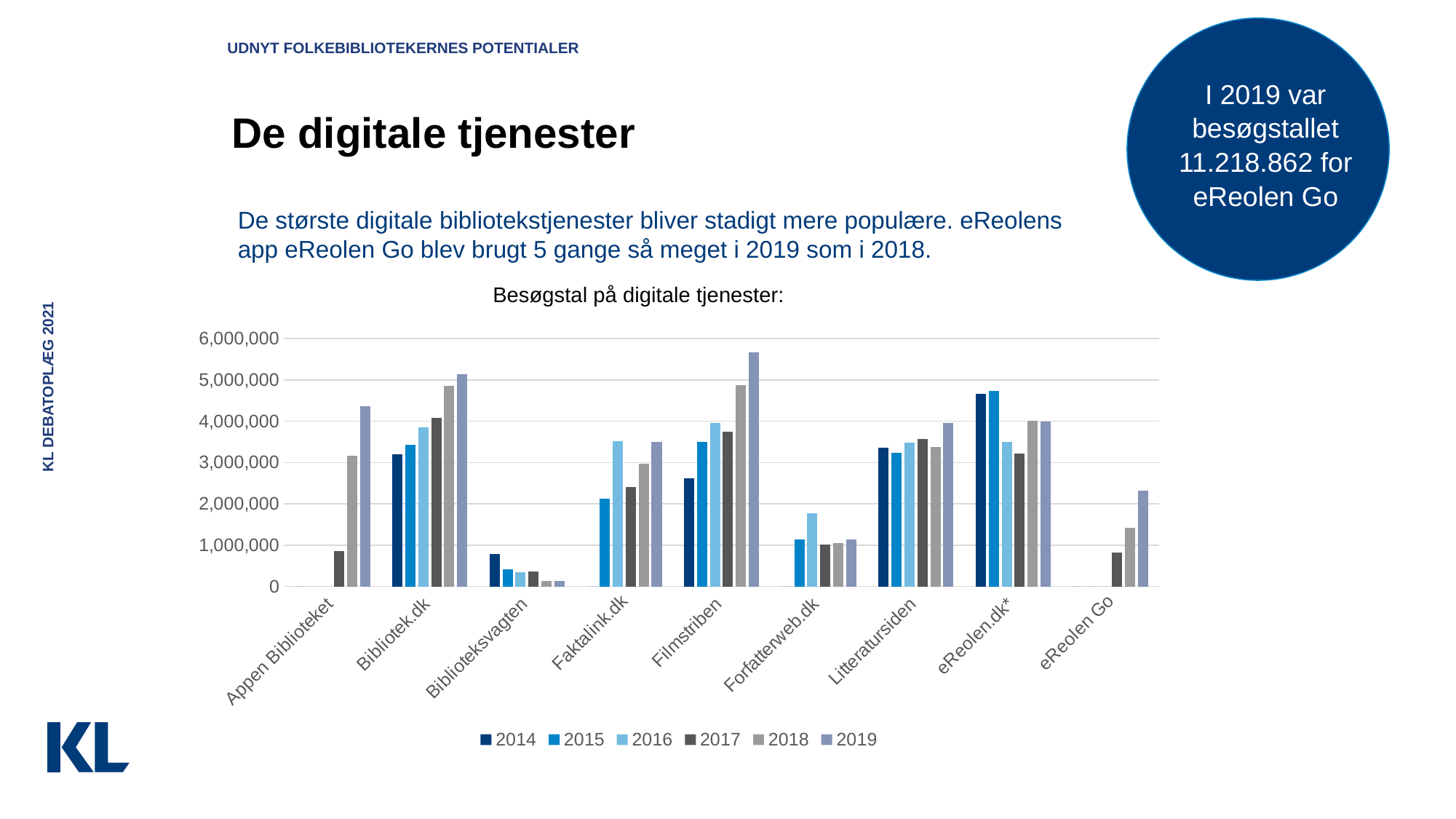
What kind of chart is shown on the slide? bar chart Is the 2016 value for Forfatterweb.dk greater or less than 2,000,000? less Which is larger in 2019: Bibliotek.dk or Appen Biblioteket? Bibliotek.dk How many series (years) does the chart legend list? 6 What is the title of the chart? Besøgstal på digitale tjenester: How many digital services (categories) are shown on the x axis of the chart? 9 Is the 2019 value for Filmstriben greater or less than 5,000,000? greater Which service has the lowest 2019 value in the chart? Biblioteksvagten Do the values for Bibliotek.dk rise or fall from 2014 to 2019? rise Is the 2014 value for Biblioteksvagten greater or less than 1,000,000? less Which service has the highest 2019 value in the chart? Filmstriben